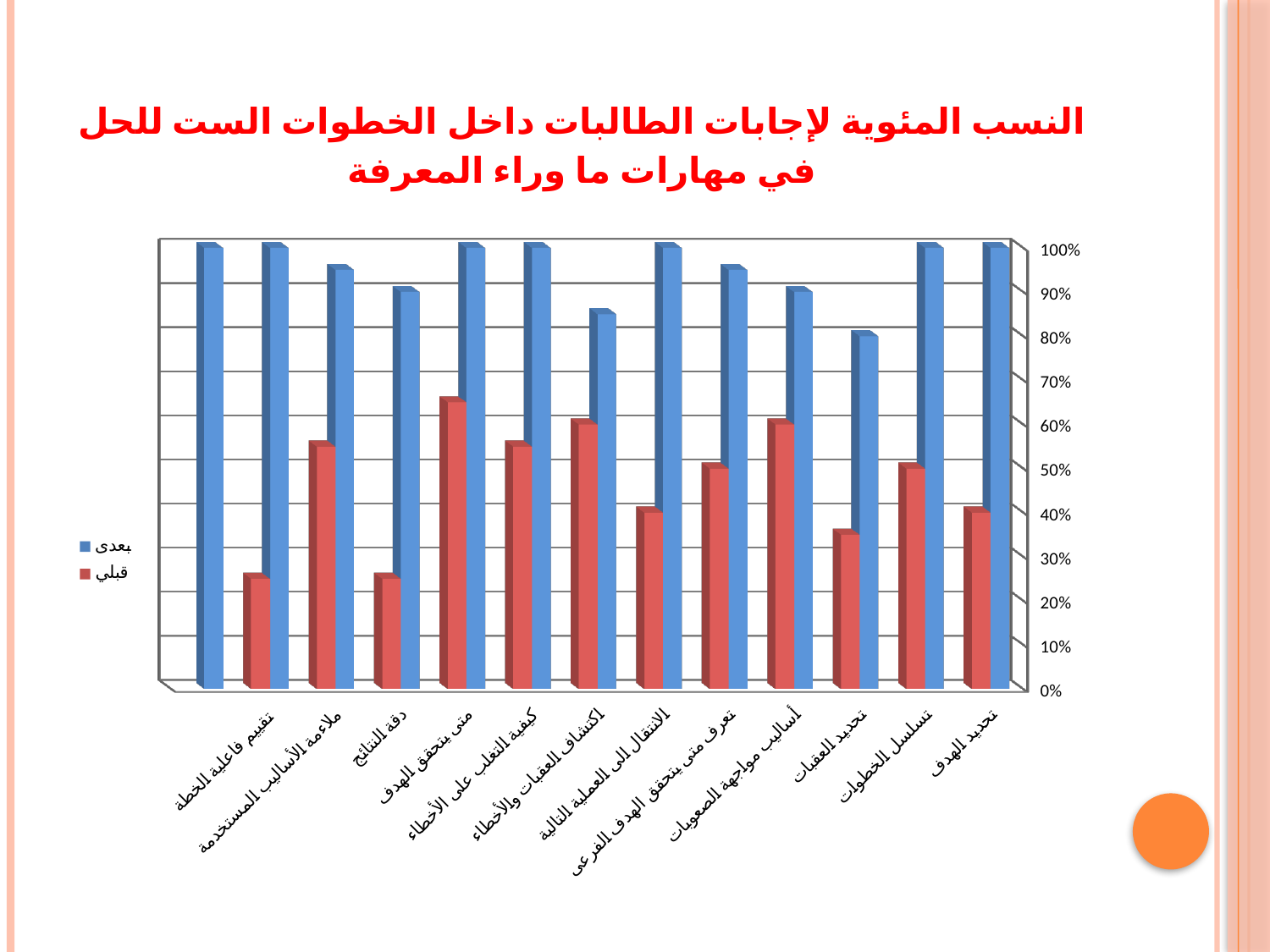
What kind of chart is shown on the slide? bar chart Which is larger for تحديد الهدف, the بعدى value or the قبلي value? بعدى Is the قبلي value for تحديد العقبات greater or less than 40%? less What are the two series named in the legend? بعدى and قبلي Which category has the lowest value in the بعدى series? تحديد العقبات Is the بعدى value for تحديد العقبات greater or less than 90%? less What is the value of the بعدى series for تسلسل الخطوات? 100% What is the value of the بعدى series for تحديد الهدف? 100% Which has the larger قبلي value, تسلسل الخطوات or تحديد العقبات? تسلسل الخطوات Is the قبلي value for أساليب مواجهة الصعوبات greater or less than 50%? greater How many series does the legend list? 2 What is the highest value shown on the vertical axis? 100%